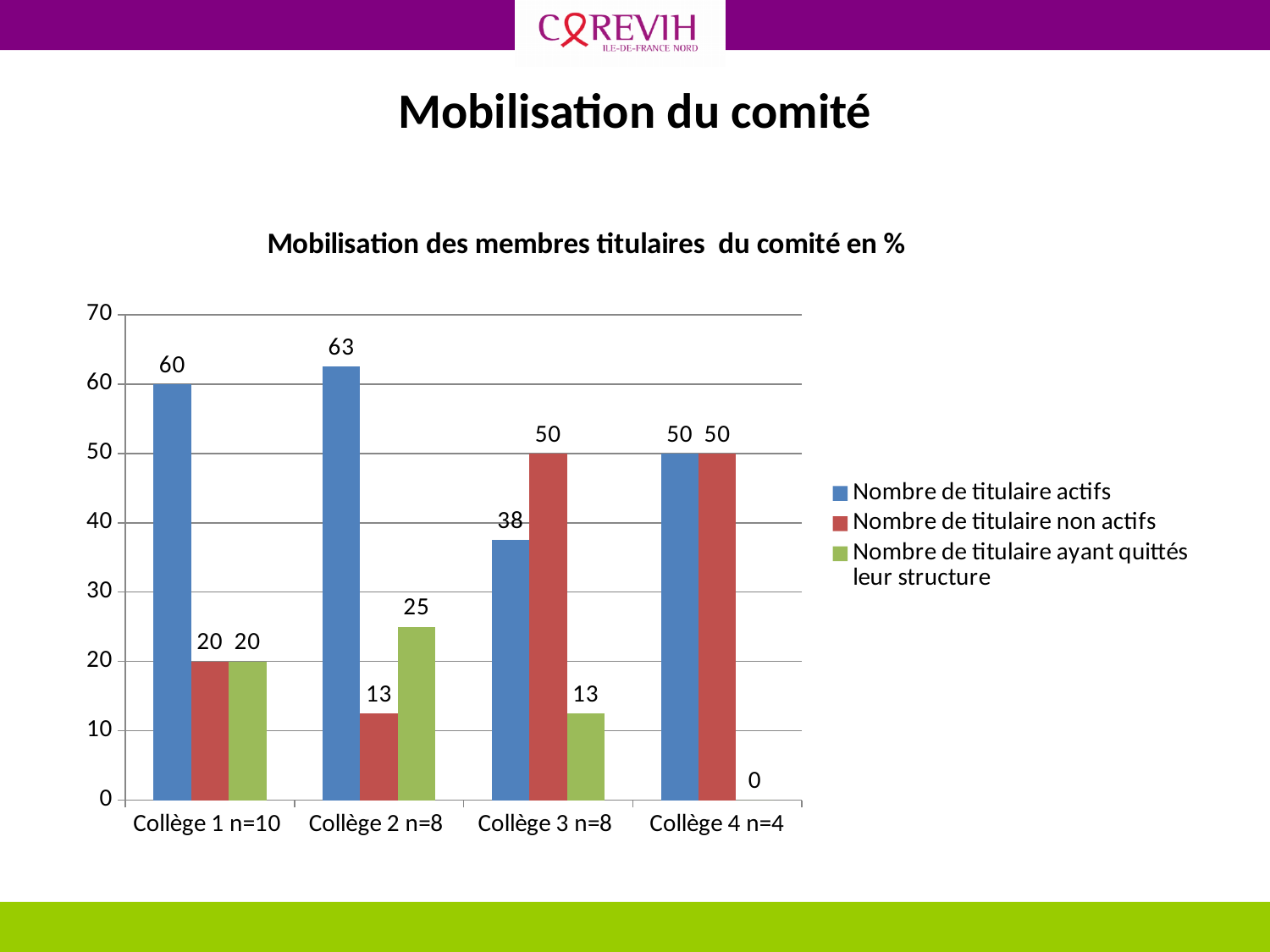
How many categories are shown on the x axis? 4 Which category has the highest value for Nombre de titulaire actifs? Collège 2 n=8 What is the value for Nombre de titulaire ayant quittés leur structure in Collège 4 n=4? 0 What is the title of the chart? Mobilisation des membres titulaires du comité en % How many series does the legend list? 3 What is the difference between Nombre de titulaire actifs and Nombre de titulaire non actifs in Collège 2 n=8? 50 What is the value for Nombre de titulaire non actifs in Collège 3 n=8? 50 In Collège 3 n=8, which is larger: Nombre de titulaire actifs or Nombre de titulaire non actifs? Nombre de titulaire non actifs What is the value for Nombre de titulaire actifs in Collège 1 n=10? 60 What kind of chart is shown on the slide? Bar chart What is the value for Nombre de titulaire ayant quittés leur structure in Collège 2 n=8? 25 Which category has the lowest value for Nombre de titulaire actifs? Collège 3 n=8